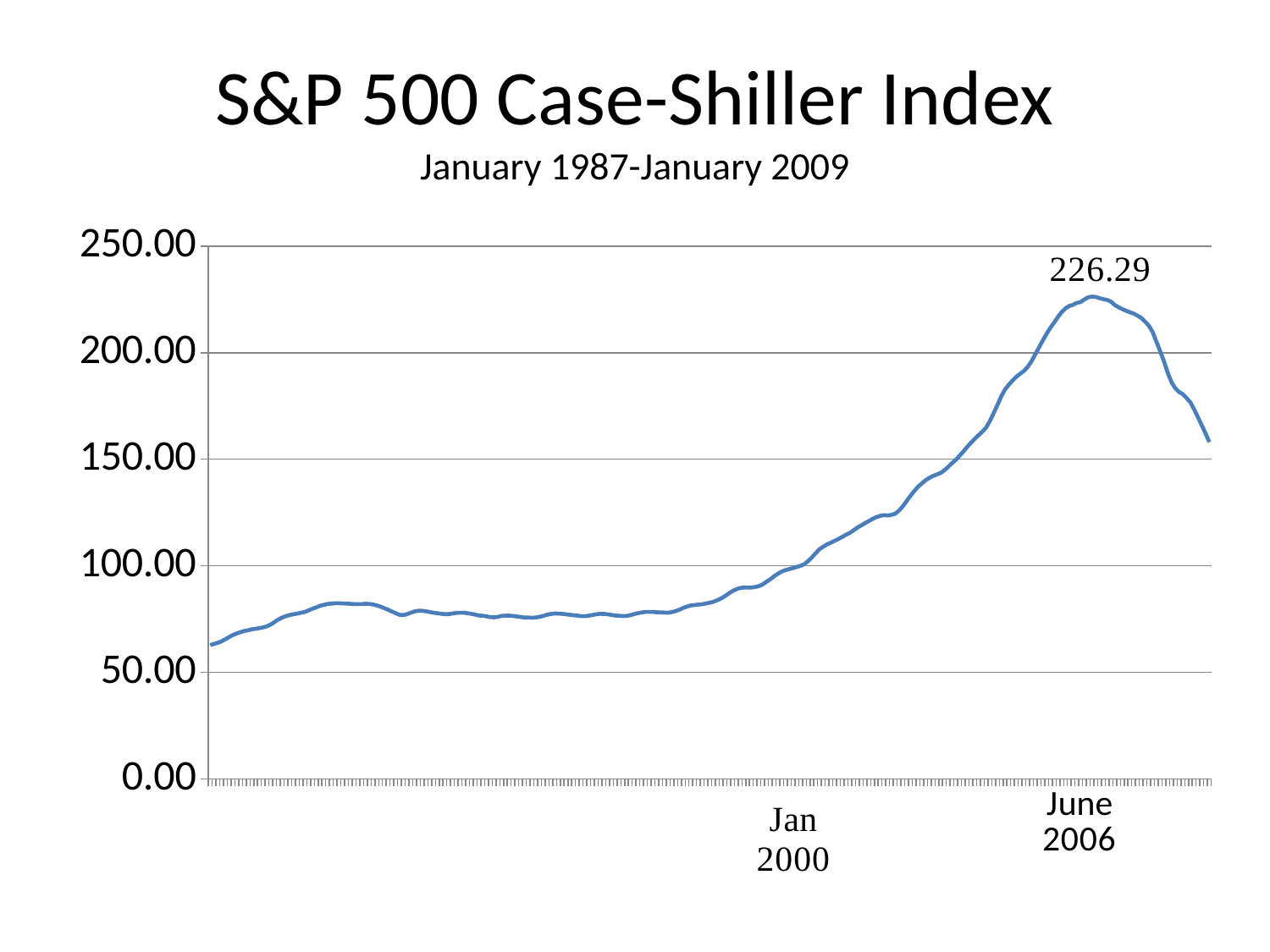
Is the value of the index at the start of the series (January 1987) greater or less than 100? less Does the index rise or fall between Jan 2000 and June 2006? rise Is the value of the index at the end of the series (January 2009) greater or less than 200? less What time period does the chart subtitle say the data covers? January 1987-January 2009 Is the value of the index at the start of the series (January 1987) greater or less than 50? greater Which is larger, the index value in June 2006 or the index value in Jan 2000? June 2006 What is the title of the chart? S&P 500 Case-Shiller Index What kind of chart is shown on the slide? line chart What is the highest value labelled on the S&P 500 Case-Shiller Index line? 226.29 Does the index rise or fall after June 2006? fall At which date does the S&P 500 Case-Shiller Index reach its labelled peak of 226.29? June 2006